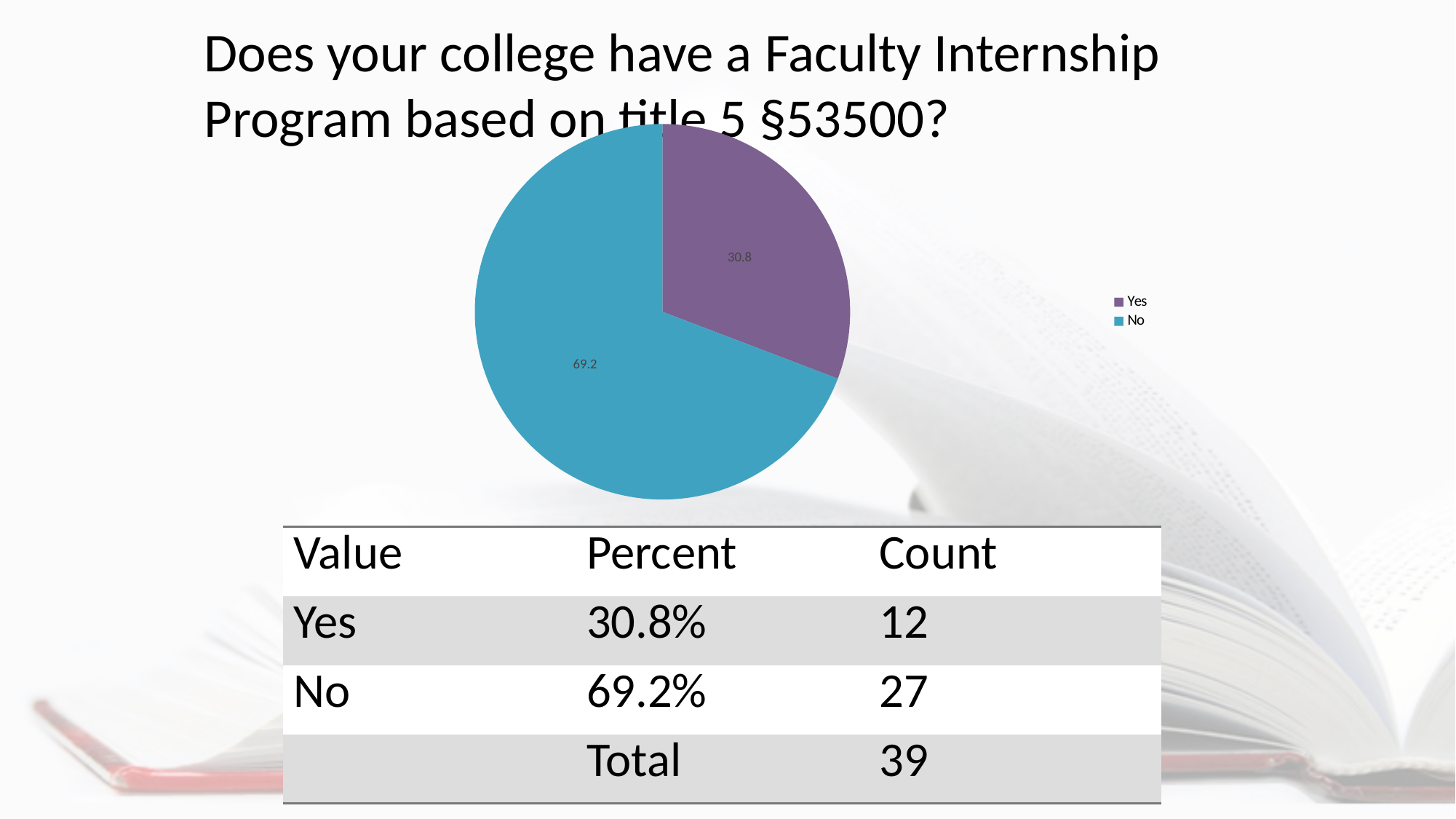
How many entries does the legend list? 2 What value is labelled on the No slice of the pie chart? 69.2 Which category has the largest slice of the pie chart? No Which category has the smallest slice of the pie chart? Yes How many slices does the pie chart have? 2 What colour is the Yes slice in the pie chart? purple What value is labelled on the Yes slice of the pie chart? 30.8 What is the difference between the No and Yes values shown on the pie chart? 38.4 What is the total count shown in the table below the chart? 39 What type of chart is shown on the slide? pie chart Which slice is larger, Yes or No? No What share of the pie does the No slice represent? 69.2%